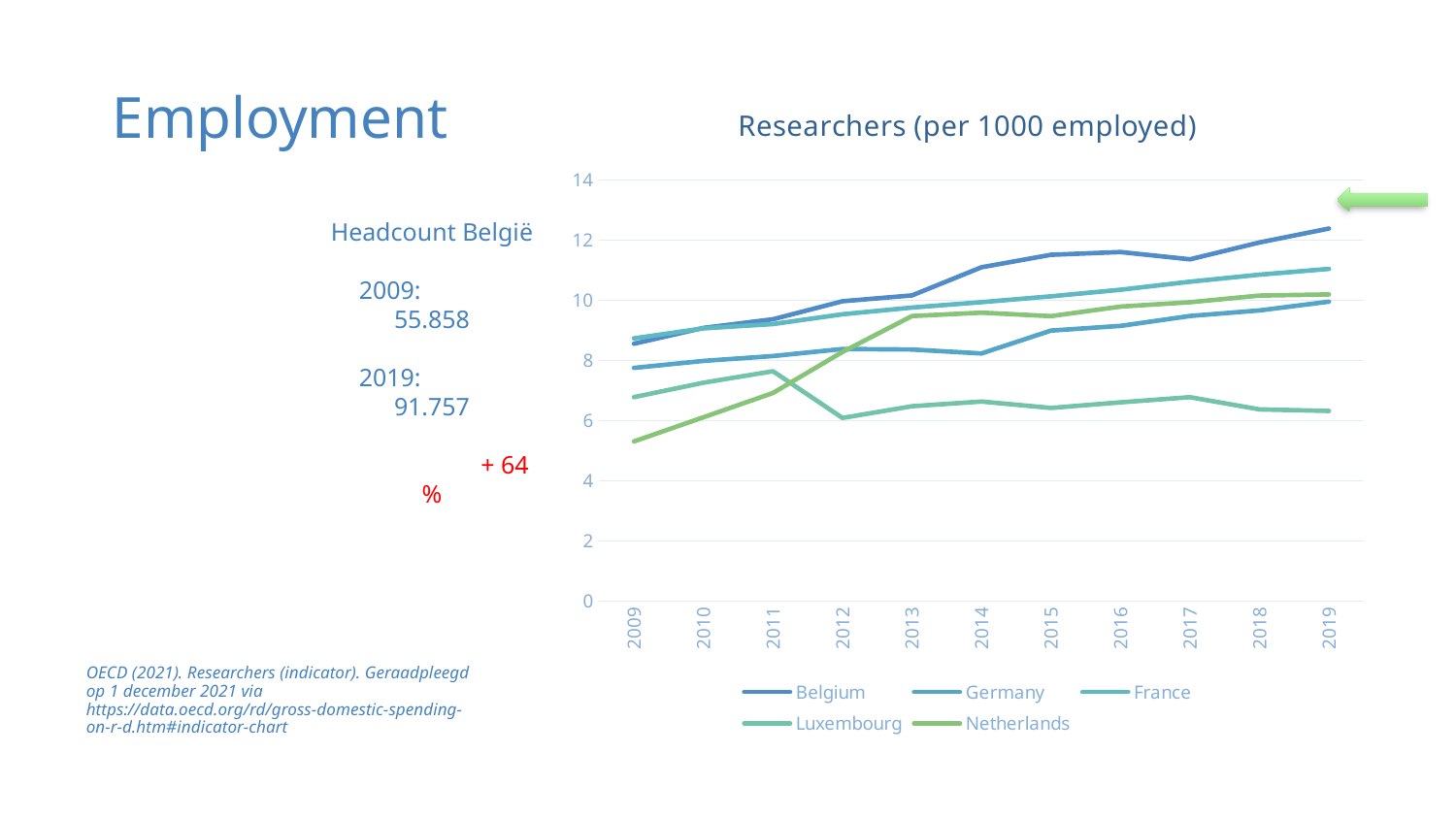
Does the line for Belgium rise or fall from 2009 to 2019? rise Is the value for France in 2019 greater or less than 10? greater Is the value for Netherlands in 2009 greater or less than 6? less Is the value for Luxembourg in 2019 greater or less than 8? less How many series does the legend of the chart list? 5 Which country has the lowest number of researchers per 1000 employed in 2019? Luxembourg How many years are plotted along the x axis of the chart? 11 In 2019, which is larger: the value for Belgium or the value for Germany? Belgium Which country has the highest number of researchers per 1000 employed in 2019? Belgium What kind of chart is shown on the slide? line chart Which country has the lowest number of researchers per 1000 employed in 2009? Netherlands